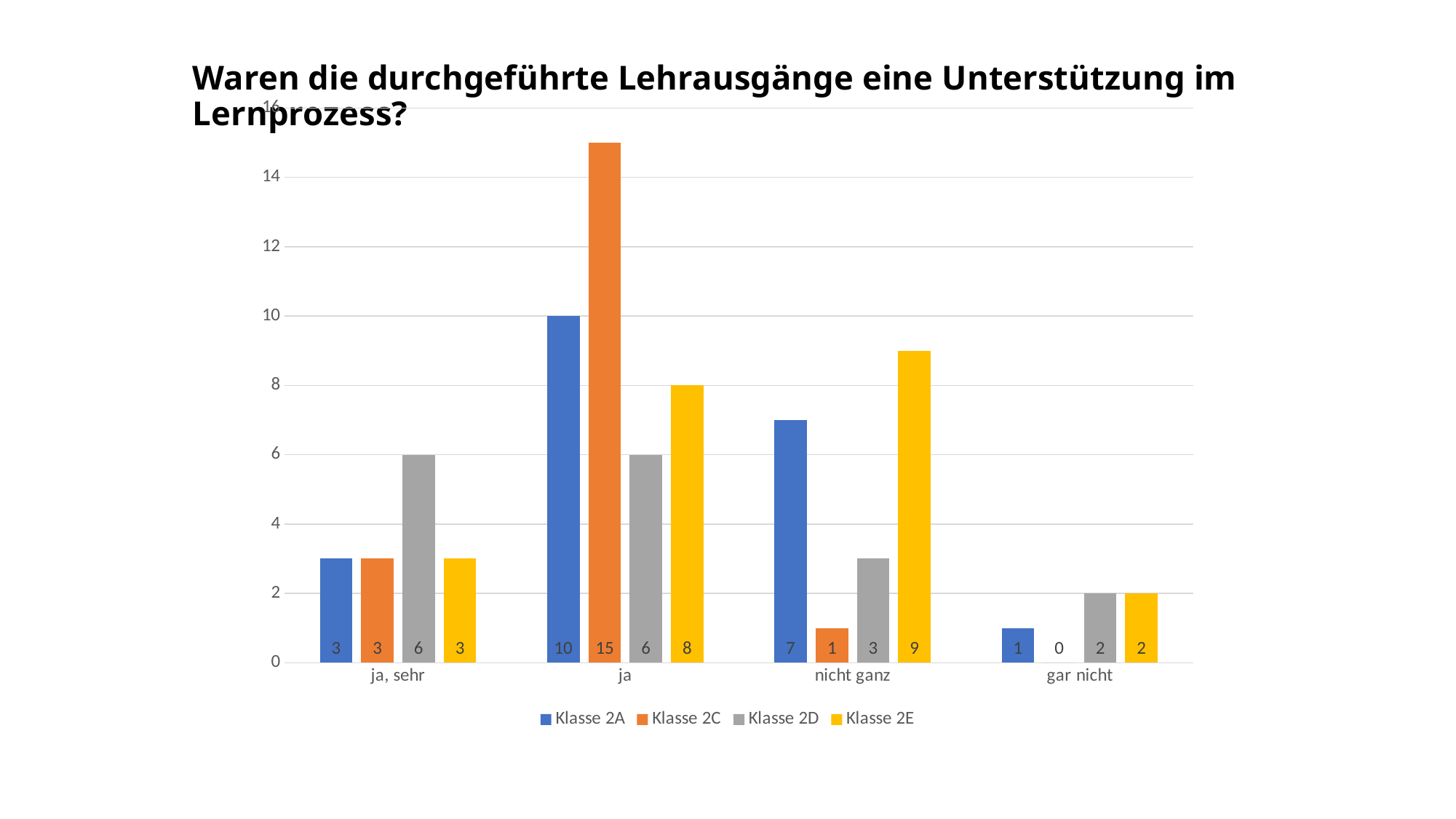
How many series does the legend list? 4 Which class has the lowest value in the category "nicht ganz"? Klasse 2C What value does Klasse 2C have for the category "gar nicht"? 0 Which colour represents Klasse 2E in the chart? Yellow Which class has the highest value in the category "ja"? Klasse 2C What value does Klasse 2C have for the category "ja"? 15 What kind of chart is shown on the slide? Bar chart What value does Klasse 2E have for the category "nicht ganz"? 9 Which is larger: Klasse 2A for "nicht ganz" or Klasse 2E for "nicht ganz"? Klasse 2E How many categories are shown on the x axis? 4 What is the difference between Klasse 2C and Klasse 2A in the category "ja"? 5 What value does Klasse 2D have for the category "ja, sehr"? 6